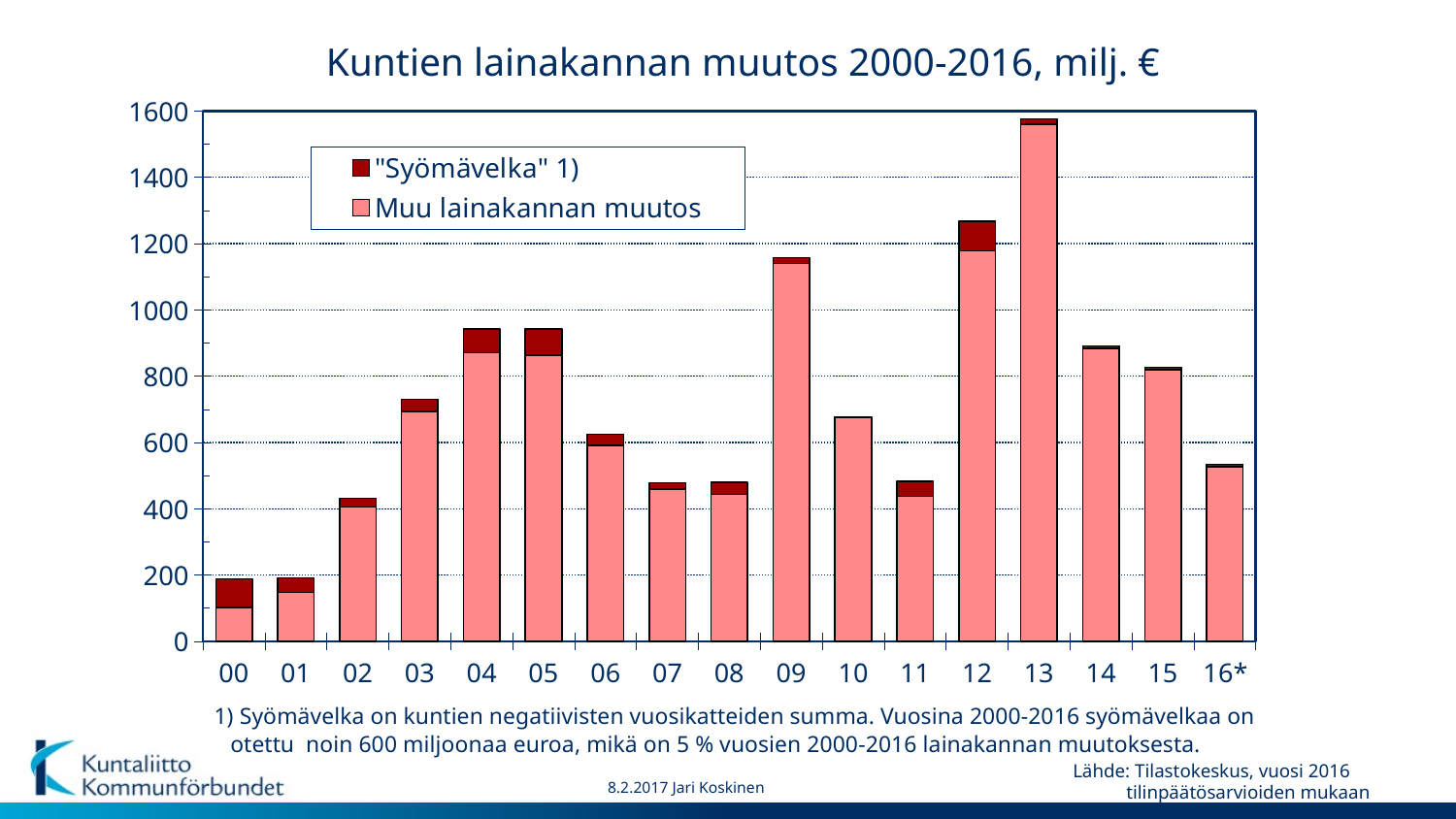
What is the title of the chart? Kuntien lainakannan muutos 2000-2016, milj. € Is the total value for 07 greater or less than 600? less Is the total value for 13 greater or less than 1400? greater Do the total bar values rise or fall from 13 to 16*? fall Is the total value for 10 greater or less than 800? less What kind of chart is shown on the slide? Stacked bar chart Which has the larger total bar, 09 or 12? 12 How many years (categories) are shown on the x axis? 17 Which year has the highest total bar? 13 Which has the larger total bar, 02 or 16*? 16* How many series does the legend list? 2